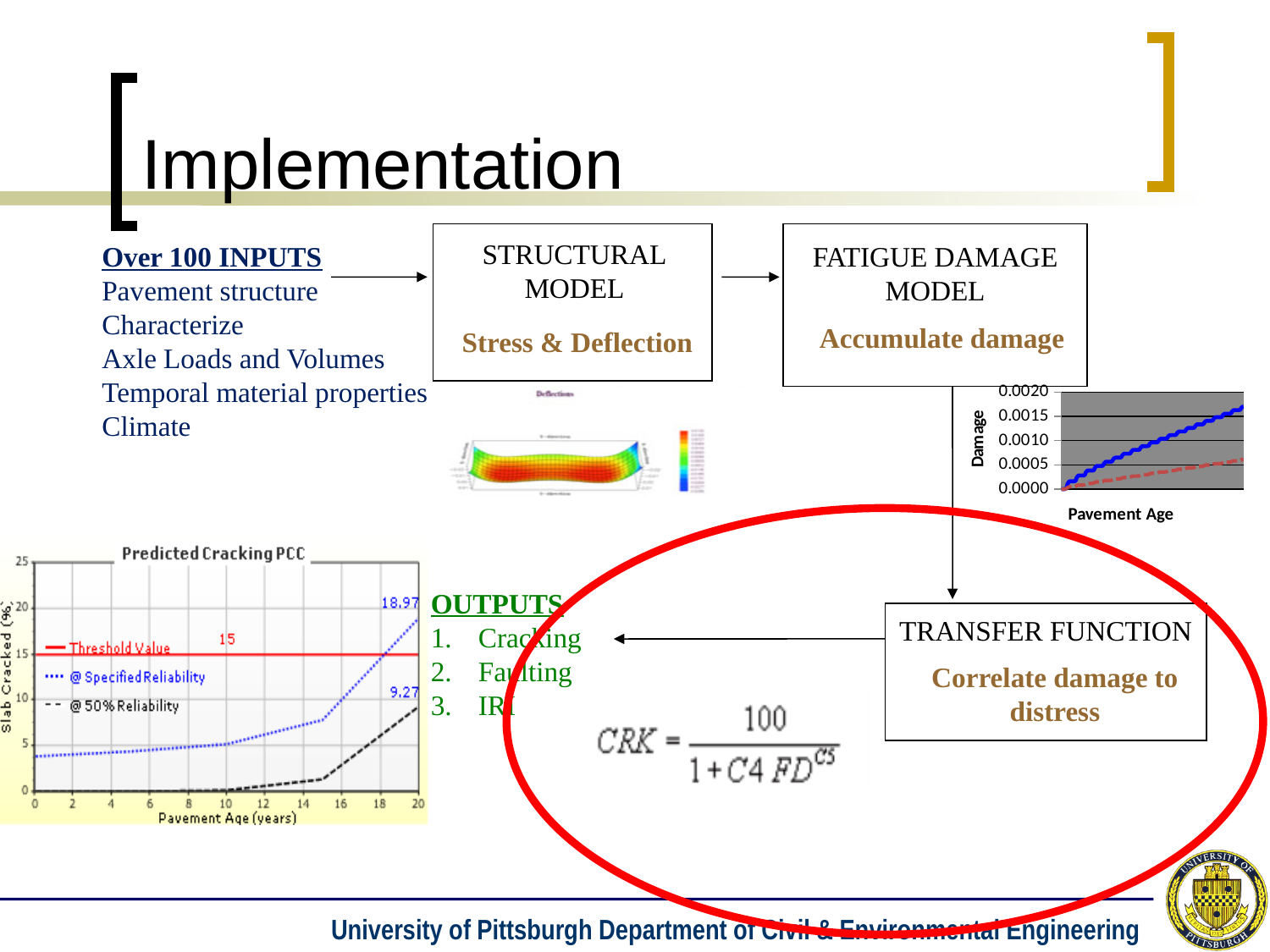
In the 'Predicted Cracking PCC' chart, which series has the larger value at 20 years: '@ Specified Reliability' or '@ 50% Reliability'? @ Specified Reliability In the 'Predicted Cracking PCC' chart, does the '@ Specified Reliability' series rise or fall as pavement age increases? rise In the 'Predicted Cracking PCC' chart, is the '@ 50% Reliability' value at 20 years greater or less than 10? less In the 'Predicted Cracking PCC' chart, what is the Threshold Value? 15 In the Damage vs Pavement Age chart on the right, is the final value of the red dashed line greater or less than 0.0010? less What is the x-axis title of the 'Predicted Cracking PCC' chart? Pavement Age (years) How many series does the legend of the 'Predicted Cracking PCC' chart list? 3 In the 'Predicted Cracking PCC' chart, what is the value of the '@ 50% Reliability' series at 20 years? 9.27 In the 'Predicted Cracking PCC' chart, what is the difference between the '@ Specified Reliability' and '@ 50% Reliability' values at 20 years? 9.70 What kind of chart is the 'Predicted Cracking PCC' chart? line chart In the Damage vs Pavement Age chart on the right, is the final value of the solid blue line greater or less than 0.0015? greater In the 'Predicted Cracking PCC' chart, what is the value of the '@ Specified Reliability' series at 20 years? 18.97